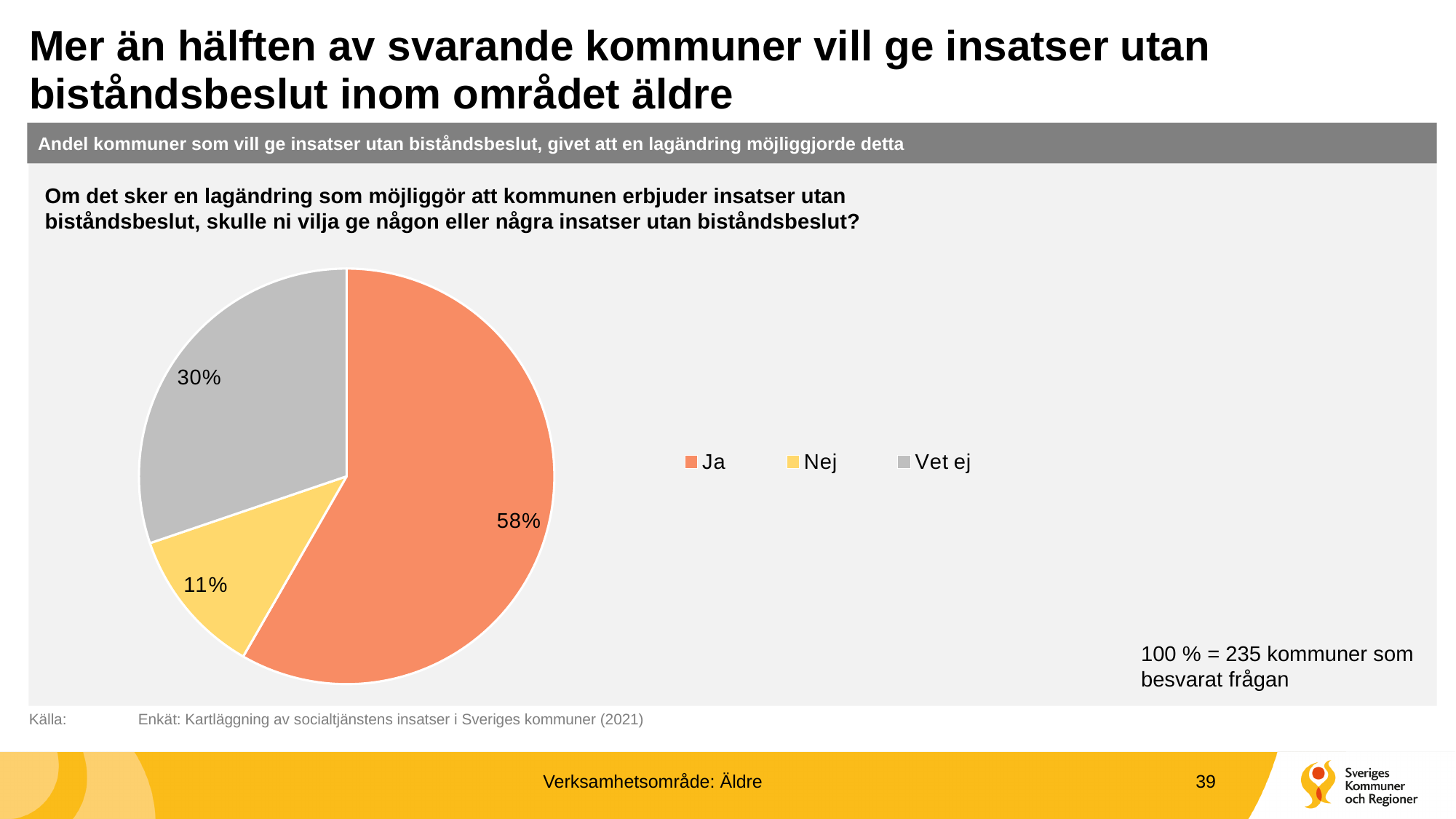
What colour is the "Vet ej" slice? grey What is the difference in percentage points between the "Ja" slice and the "Vet ej" slice? 28 What share of the pie does "Ja" represent? 58% What share of the pie does "Nej" represent? 11% Which category has the largest slice of the pie? Ja Which category has the smallest slice of the pie? Nej What is the difference in percentage points between the "Vet ej" slice and the "Nej" slice? 19 Which is larger, the "Nej" slice or the "Vet ej" slice? Vet ej What kind of chart is shown on the slide? pie chart How many categories does the legend list? 3 How many kommuner does 100 % correspond to according to the note on the slide? 235 What share of the pie does "Vet ej" represent? 30%